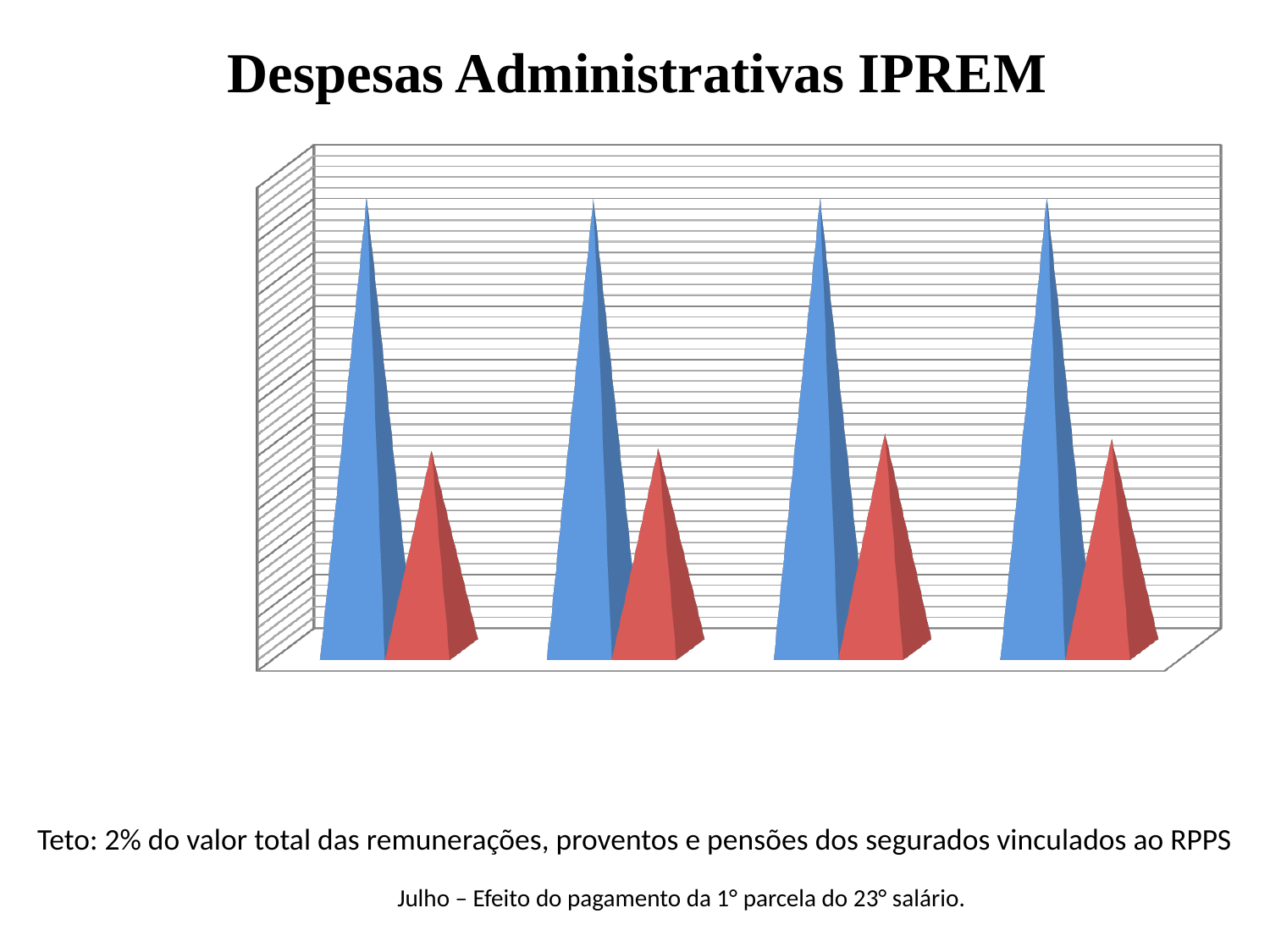
What two colours are used for the bars in the chart? blue and red What is the title of the chart on the slide? Despesas Administrativas IPREM How many groups of bars are plotted in the chart? 4 How many differently coloured series are plotted in the chart? 2 What kind of chart is shown on the slide? bar chart Is the blue bar taller than the red bar in every group of the chart? yes In the rightmost group of bars, which is shorter, the blue bar or the red bar? red In the leftmost group of bars, which is taller, the blue bar or the red bar? blue